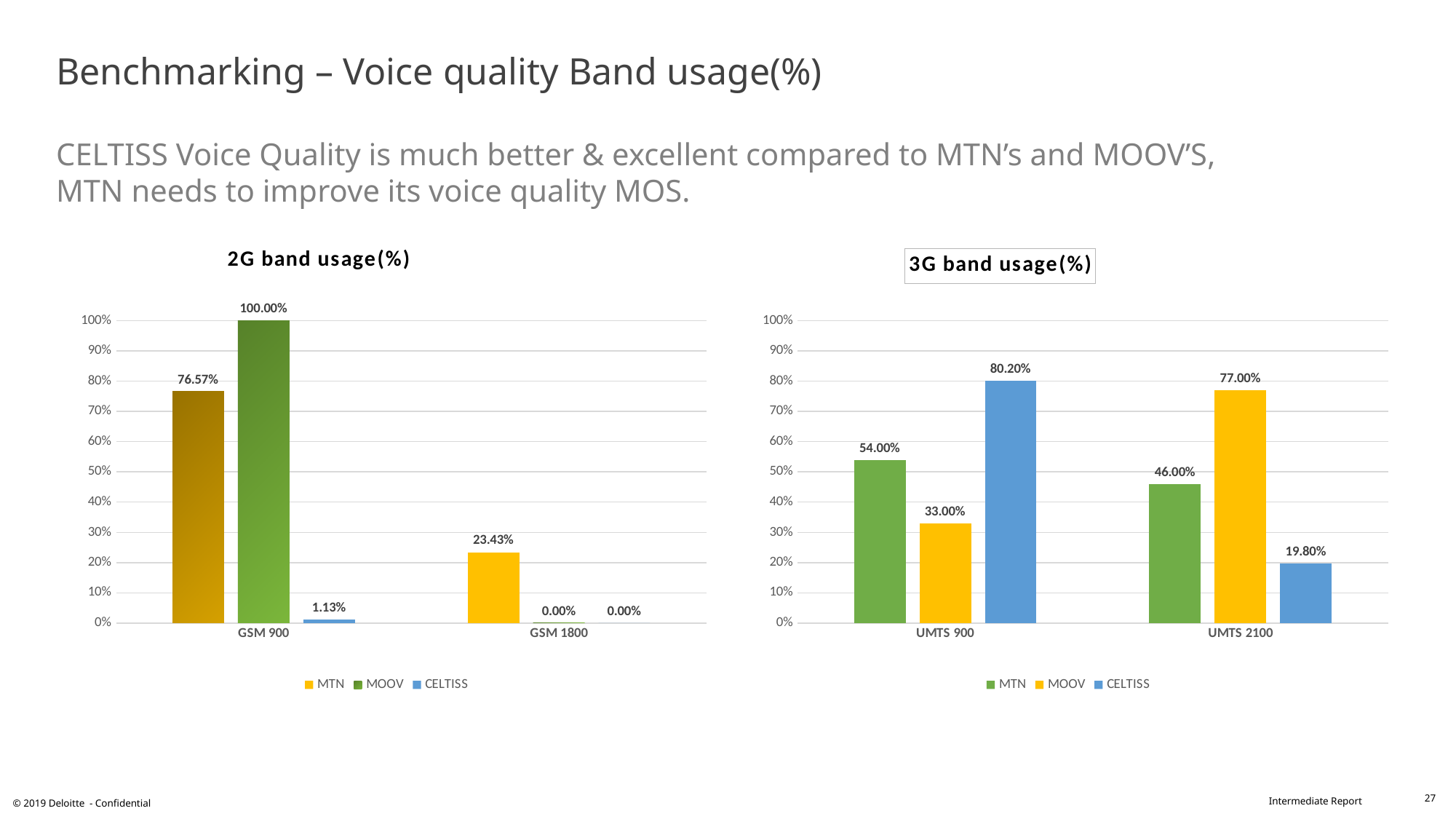
In the 2G band usage(%) chart, what is the difference between MOOV and MTN at GSM 900? 23.43% What kind of chart is the 2G band usage(%) chart? Bar chart In the 2G band usage(%) chart, what is the value for CELTISS at GSM 900? 1.13% In the 2G band usage(%) chart, what is the value for MTN at GSM 1800? 23.43% In the 2G band usage(%) chart, which operator has the lowest value at GSM 900? CELTISS In the 3G band usage(%) chart, which operator has the highest value at UMTS 900? CELTISS In the 3G band usage(%) chart, which is larger at UMTS 2100: MTN or CELTISS? MTN In the 3G band usage(%) chart, what is the difference between MTN at UMTS 900 and MTN at UMTS 2100? 8.00% In the 3G band usage(%) chart, what is the value for CELTISS at UMTS 900? 80.20% In the 2G band usage(%) chart, what is the value for MOOV at GSM 900? 100.00% How many series does the legend of the 3G band usage(%) chart list? 3 In the 3G band usage(%) chart, what is the value for MOOV at UMTS 2100? 77.00%